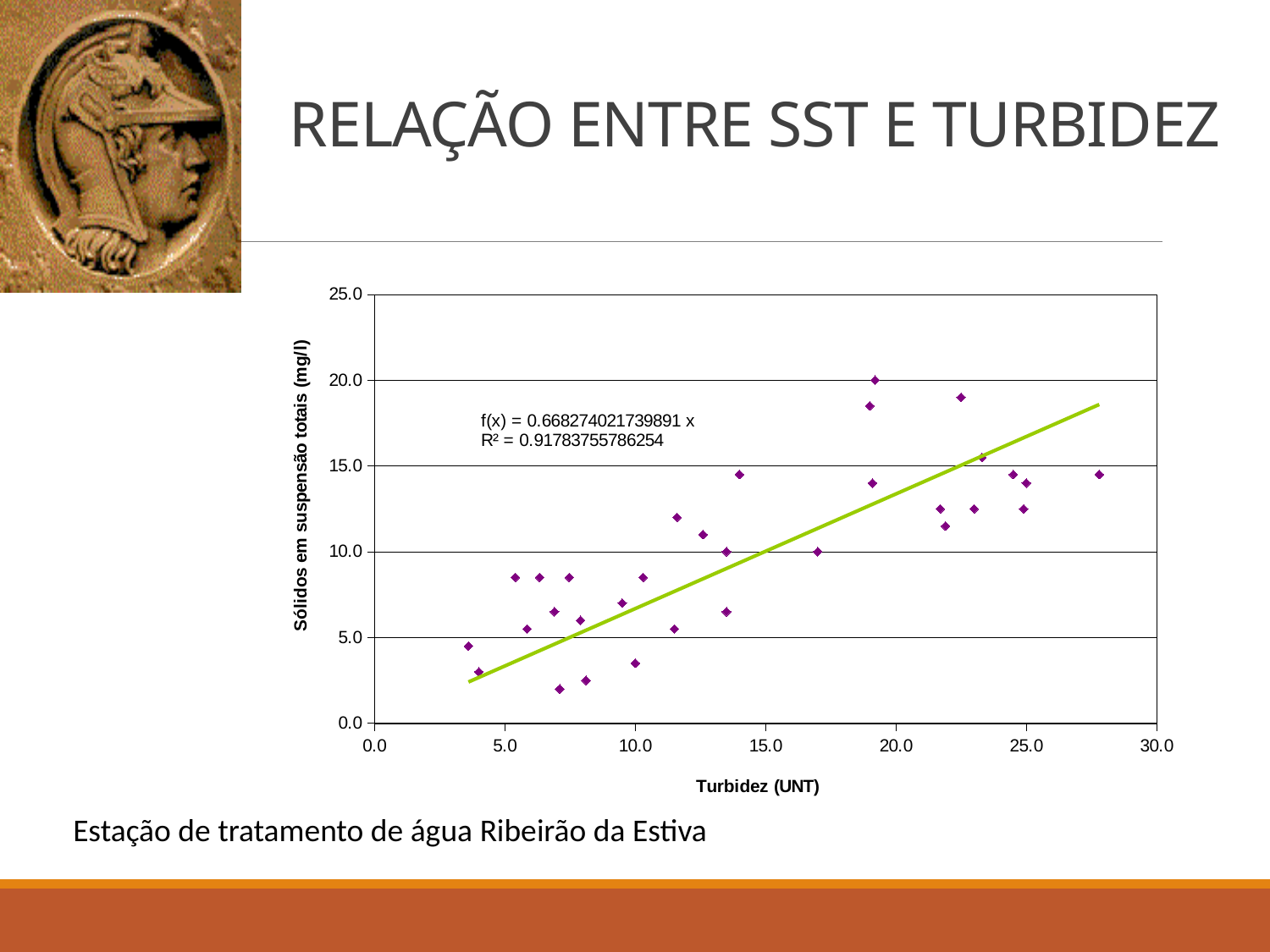
What is the trendline equation printed on the chart? f(x) = 0.668274021739891 x Is the suspended solids value for the point with the highest turbidity (near 28 UNT) greater or less than 10.0? greater Do the plotted values of suspended solids generally rise or fall as turbidity increases along the x axis? Rise What is the label of the y axis of the chart? Sólidos em suspensão totais (mg/l) What R² value is printed on the chart? 0.91783755786254 What is the label of the x axis of the chart? Turbidez (UNT) What kind of chart is shown on the slide? Scatter plot What is the highest tick value shown on the y axis? 25.0 Is the suspended solids value for the point at about 17 UNT greater or less than 15.0? less What is the highest tick value shown on the x axis? 30.0 Is the suspended solids value for the point with the lowest turbidity (near 3.5 UNT) greater or less than 10.0? less